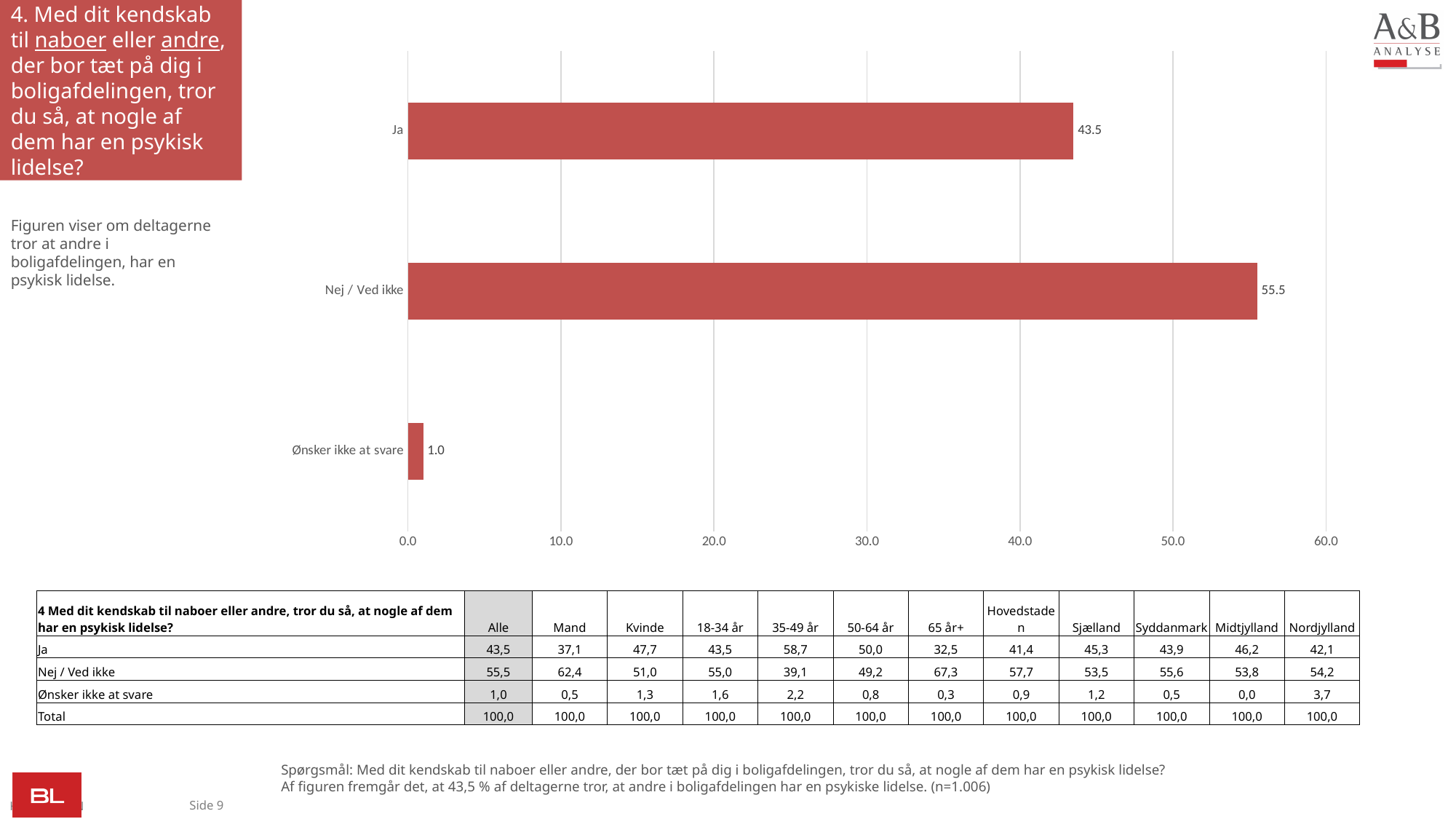
How many categories are shown in the chart? 3 Which category has the lowest value in the chart? Ønsker ikke at svare What is the value for "Nej / Ved ikke" in the chart? 55.5 What is the highest value shown on the x axis of the chart? 60.0 What is the difference between the values for "Nej / Ved ikke" and "Ja"? 12.0 Which category has the highest value in the chart? Nej / Ved ikke What is the value for "Ønsker ikke at svare" in the chart? 1.0 Is the value for "Ja" greater or less than 40.0? greater Is the value for "Nej / Ved ikke" greater or less than 50.0? greater Which is larger, the value for "Ja" or the value for "Nej / Ved ikke"? Nej / Ved ikke What is the value for "Ja" in the chart? 43.5 What kind of chart is shown on the slide? bar chart